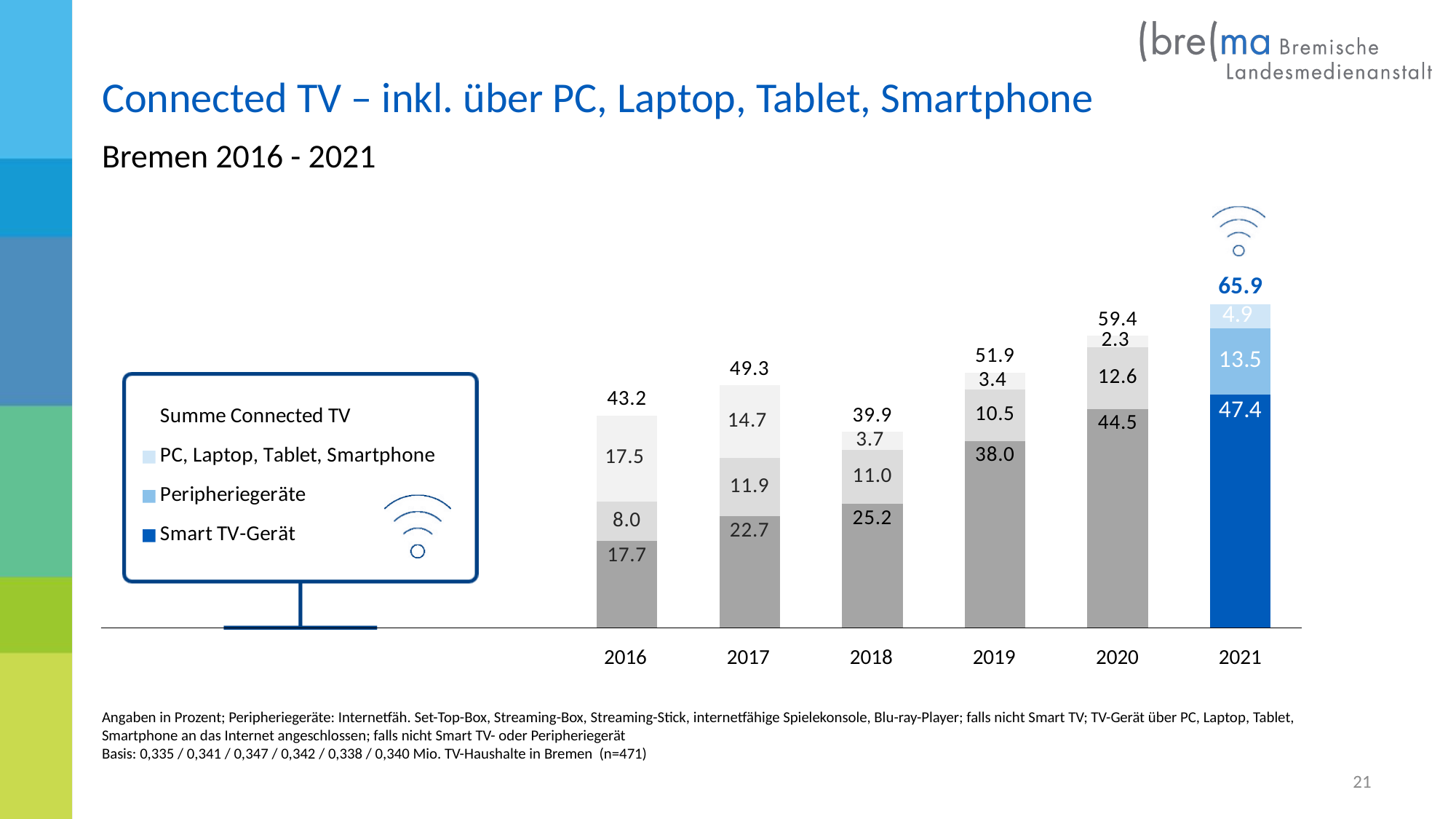
What is the Summe Connected TV total for 2019? 51.9 Which is larger: the Peripheriegeräte value in 2018 or in 2020? 2020 What is the value for Peripheriegeräte in 2017? 11.9 Which year has the lowest value for Smart TV-Gerät? 2016 How many series does the legend list? 3 What kind of chart is shown on the slide? stacked bar chart What is the value for Smart TV-Gerät in 2021? 47.4 What is the value for PC, Laptop, Tablet, Smartphone in 2016? 17.5 What is the difference between the Smart TV-Gerät values for 2020 and 2019? 6.5 Which year has the highest Summe Connected TV total? 2021 Does the Smart TV-Gerät value rise or fall from 2016 to 2021? rise How many years are shown on the x axis? 6